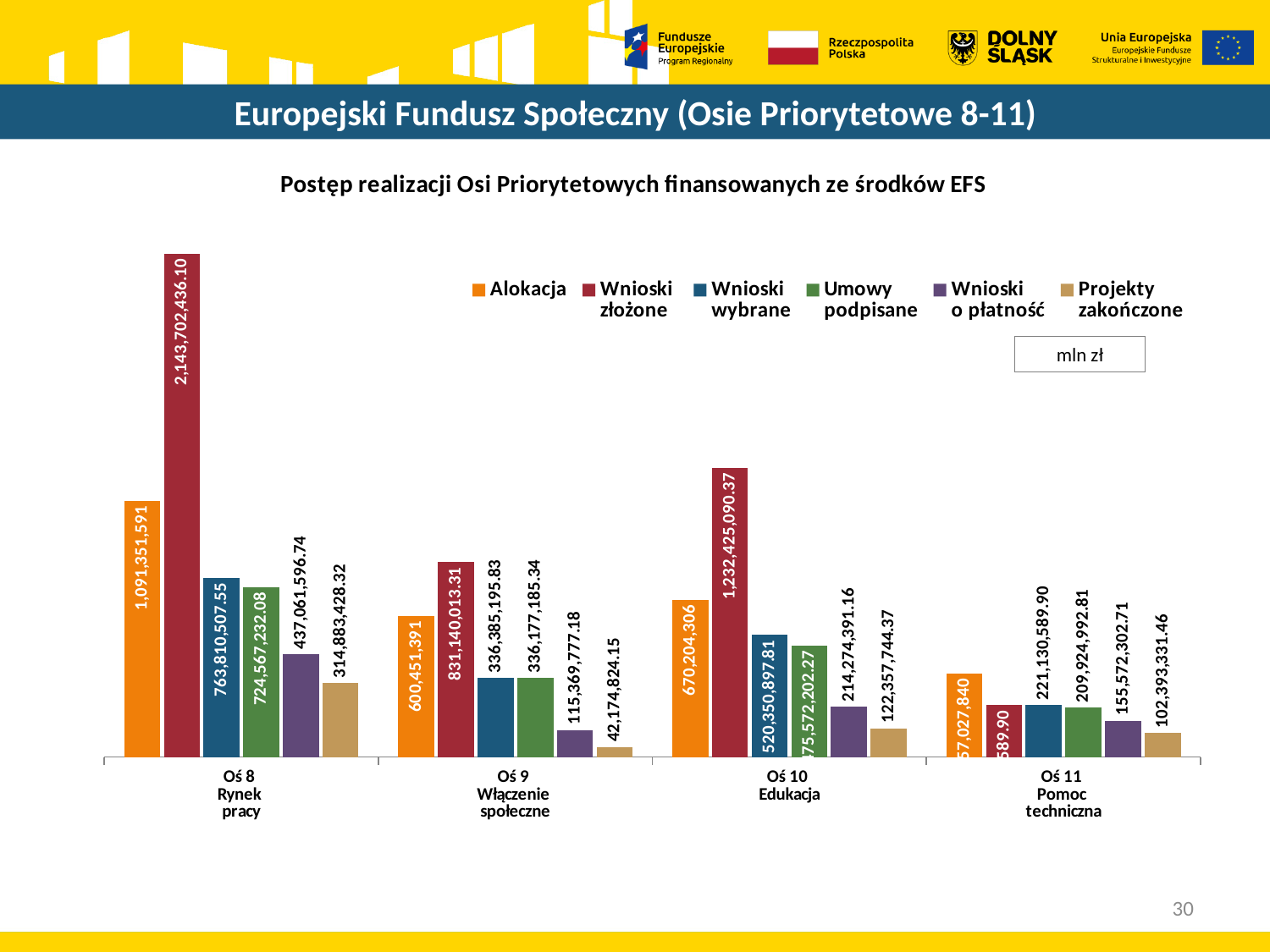
Which category has the highest Wnioski złożone value? Oś 8 Rynek pracy What is the value of Wnioski złożone for Oś 8 Rynek pracy? 2,143,702,436.10 What is the difference between Wnioski wybrane and Umowy podpisane for Oś 9 Włączenie społeczne? 208,010.49 Which is larger for Oś 9: Wnioski złożone or Alokacja? Wnioski złożone What is the value of Projekty zakończone for Oś 10 Edukacja? 122,357,744.37 What is the value of Wnioski wybrane for Oś 11 Pomoc techniczna? 221,130,589.90 Which category has the lowest Projekty zakończone value? Oś 9 Włączenie społeczne How many categories (axes) are shown on the x axis? 4 What type of chart is shown on the slide? bar chart How many series does the legend list? 6 What is the Alokacja value for Oś 9 Włączenie społeczne? 600,451,391 What unit is indicated in the box next to the legend? mln zł